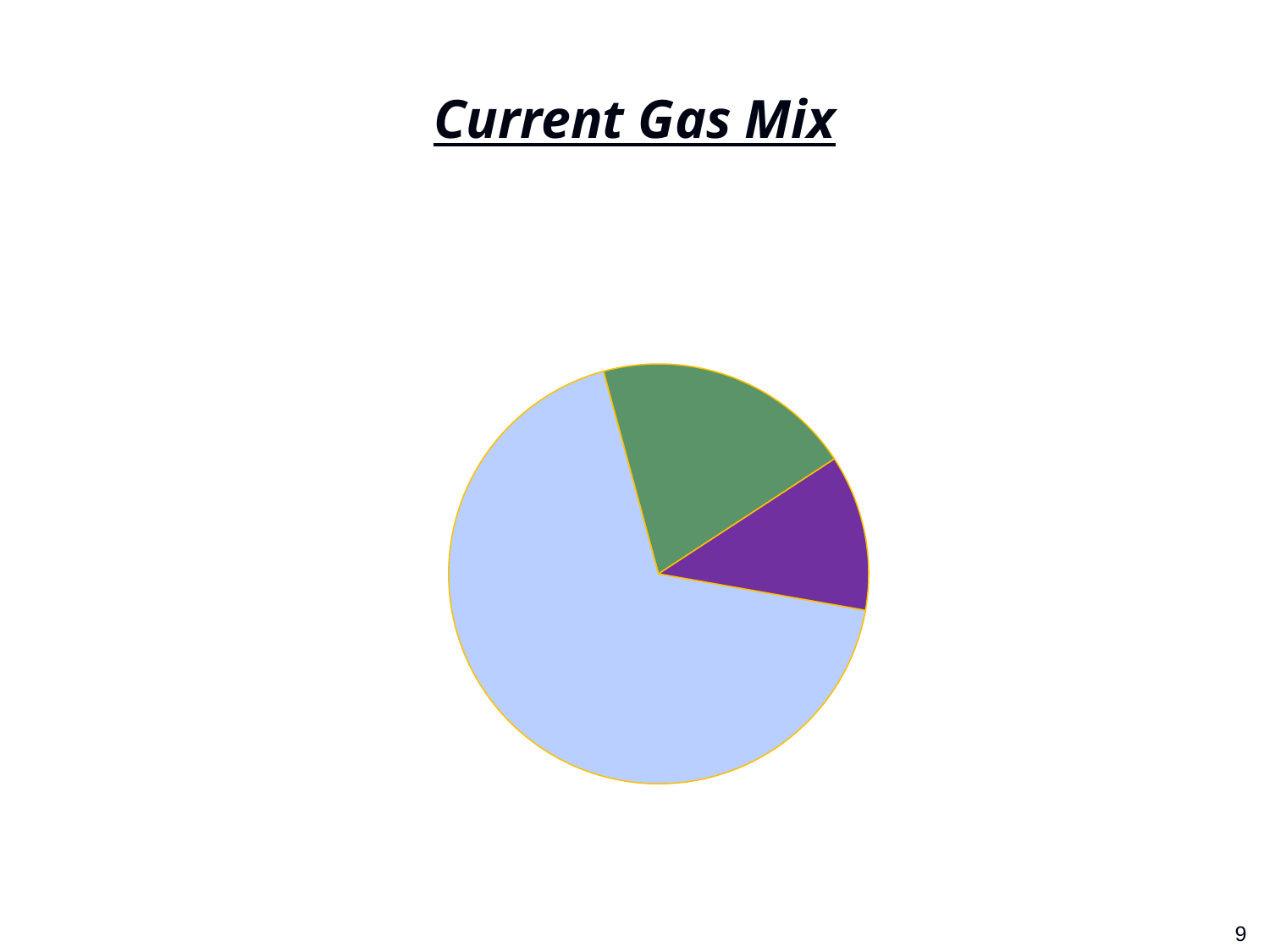
Does the pie chart show a legend? No Which slice of the pie chart is the largest? the light blue slice Which slice of the pie chart is the smallest? the purple slice What is the title of the chart on the slide? Current Gas Mix Which is larger in the pie chart, the light blue slice or the green slice? the light blue slice How many slices does the pie chart have? 3 Which is larger in the pie chart, the green slice or the purple slice? the green slice What kind of chart is shown on the slide? pie chart